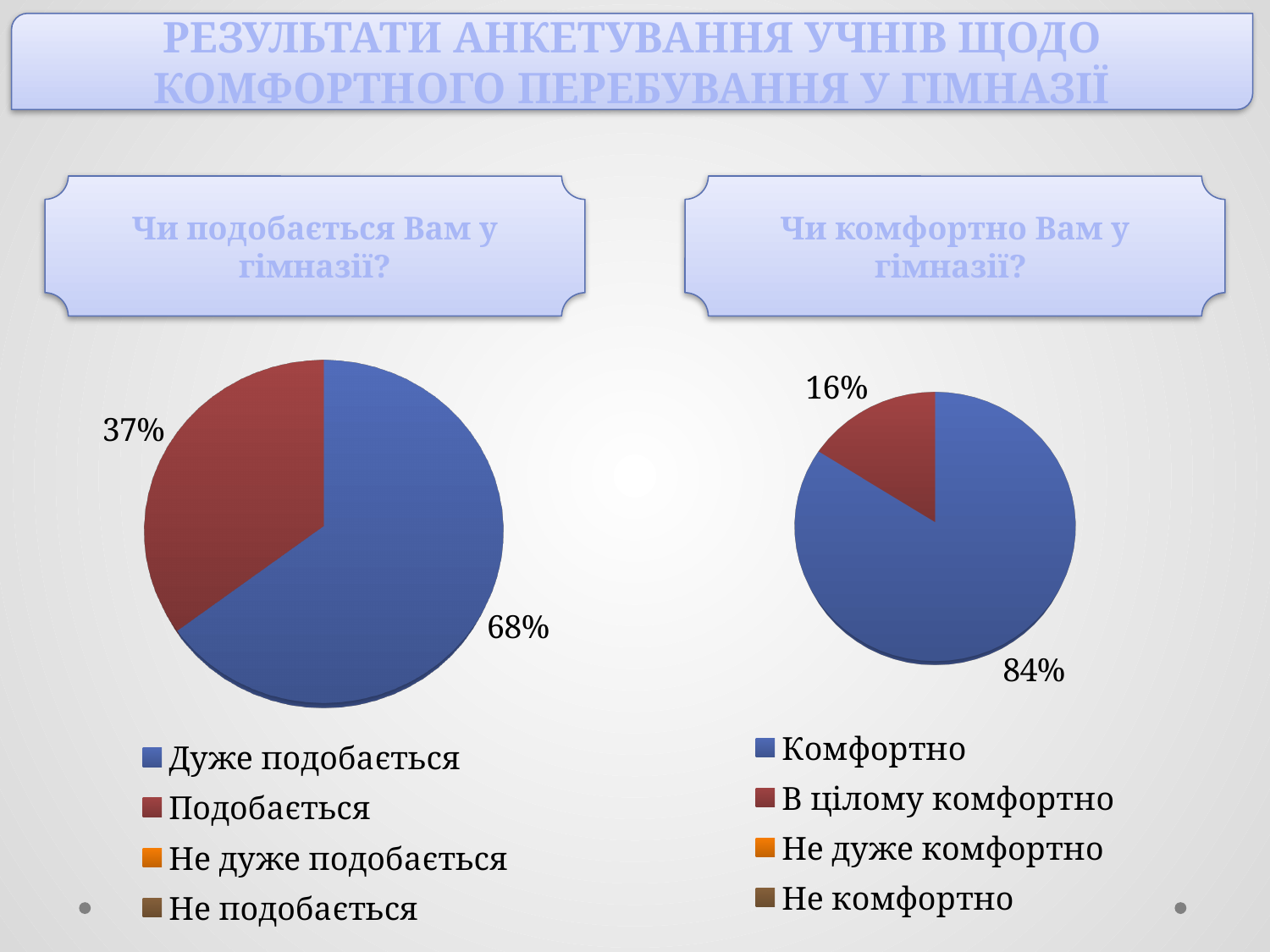
In the right chart 'Чи комфортно Вам у гімназії?', what colour is the 'Комфортно' slice? Blue In the right chart 'Чи комфортно Вам у гімназії?', what share of the pie is 'Комфортно'? 84% In the left chart 'Чи подобається Вам у гімназії?', what share of the pie is labelled 'Дуже подобається'? 68% In the left chart 'Чи подобається Вам у гімназії?', which category has the largest slice? Дуже подобається In the right chart 'Чи комфортно Вам у гімназії?', which category has the smallest labelled slice? В цілому комфортно How many entries does the legend of the right chart 'Чи комфортно Вам у гімназії?' list? 4 In the right chart 'Чи комфортно Вам у гімназії?', what is the difference between the 'Комфортно' and 'В цілому комфортно' percentages? 68% In the left chart 'Чи подобається Вам у гімназії?', what percentage is shown for 'Подобається'? 37% What type of chart is the right chart 'Чи комфортно Вам у гімназії?'? Pie chart In the left chart 'Чи подобається Вам у гімназії?', which is larger: 'Дуже подобається' or 'Подобається'? Дуже подобається How many entries does the legend of the left chart 'Чи подобається Вам у гімназії?' list? 4 In the right chart 'Чи комфортно Вам у гімназії?', what percentage is shown for 'В цілому комфортно'? 16%